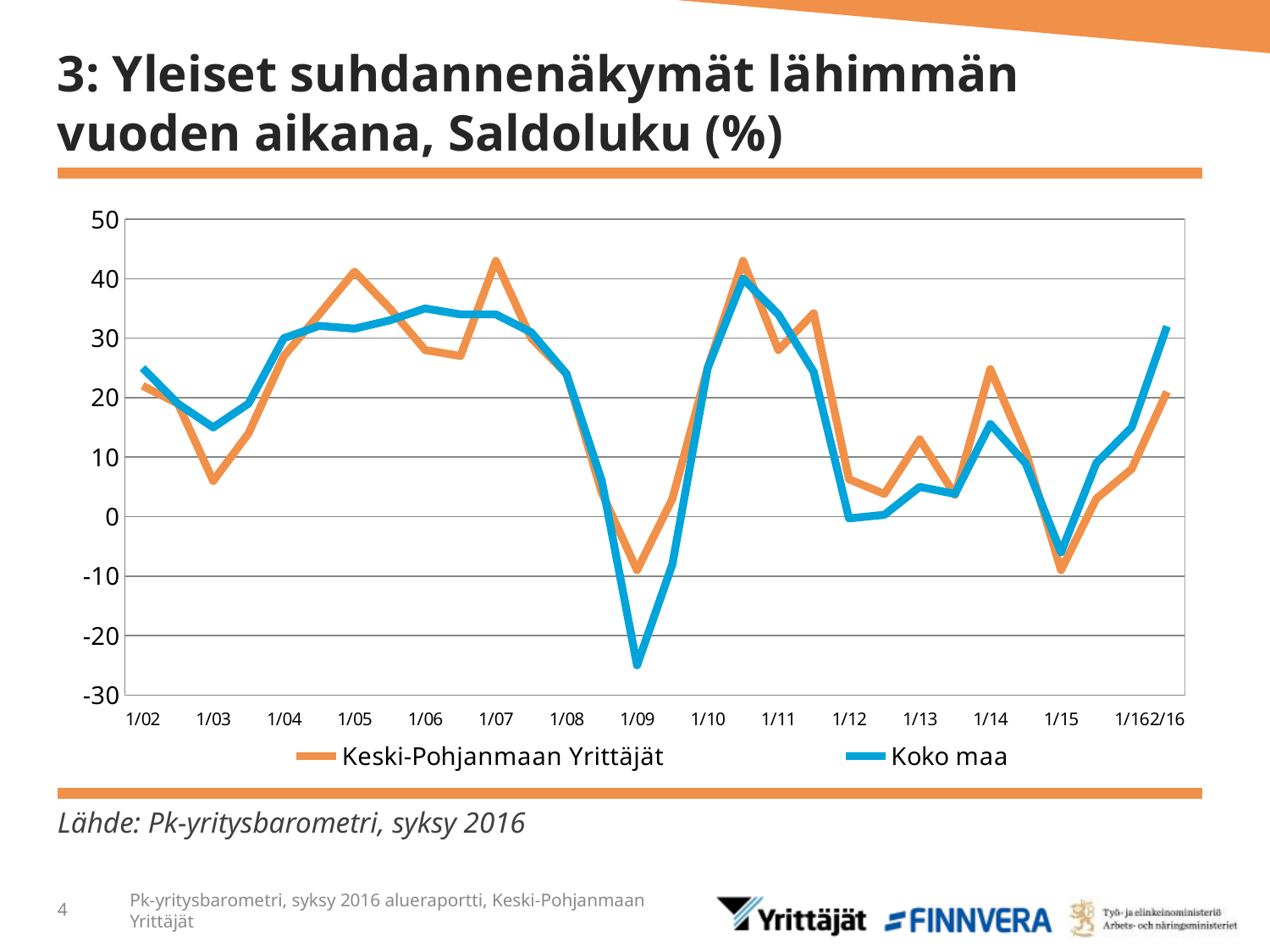
Is the value for Koko maa at 2/16 greater or less than 20? greater Is the value for Koko maa at 1/09 greater or less than -20? less What is the title of the chart on the slide? 3: Yleiset suhdannenäkymät lähimmän vuoden aikana, Saldoluku (%) At 1/09, which series has the higher value, Keski-Pohjanmaan Yrittäjät or Koko maa? Keski-Pohjanmaan Yrittäjät What kind of chart is shown on the slide? line chart Between 1/08 and 1/09, do the values of the Koko maa series rise or fall? fall At 2/16, which series has the higher value, Keski-Pohjanmaan Yrittäjät or Koko maa? Koko maa Is the value for Koko maa at 1/12 greater or less than 10? less At which x-axis point does the Koko maa series reach its lowest value? 1/09 How many series does the legend list? 2 Which two series are listed in the legend? Keski-Pohjanmaan Yrittäjät and Koko maa